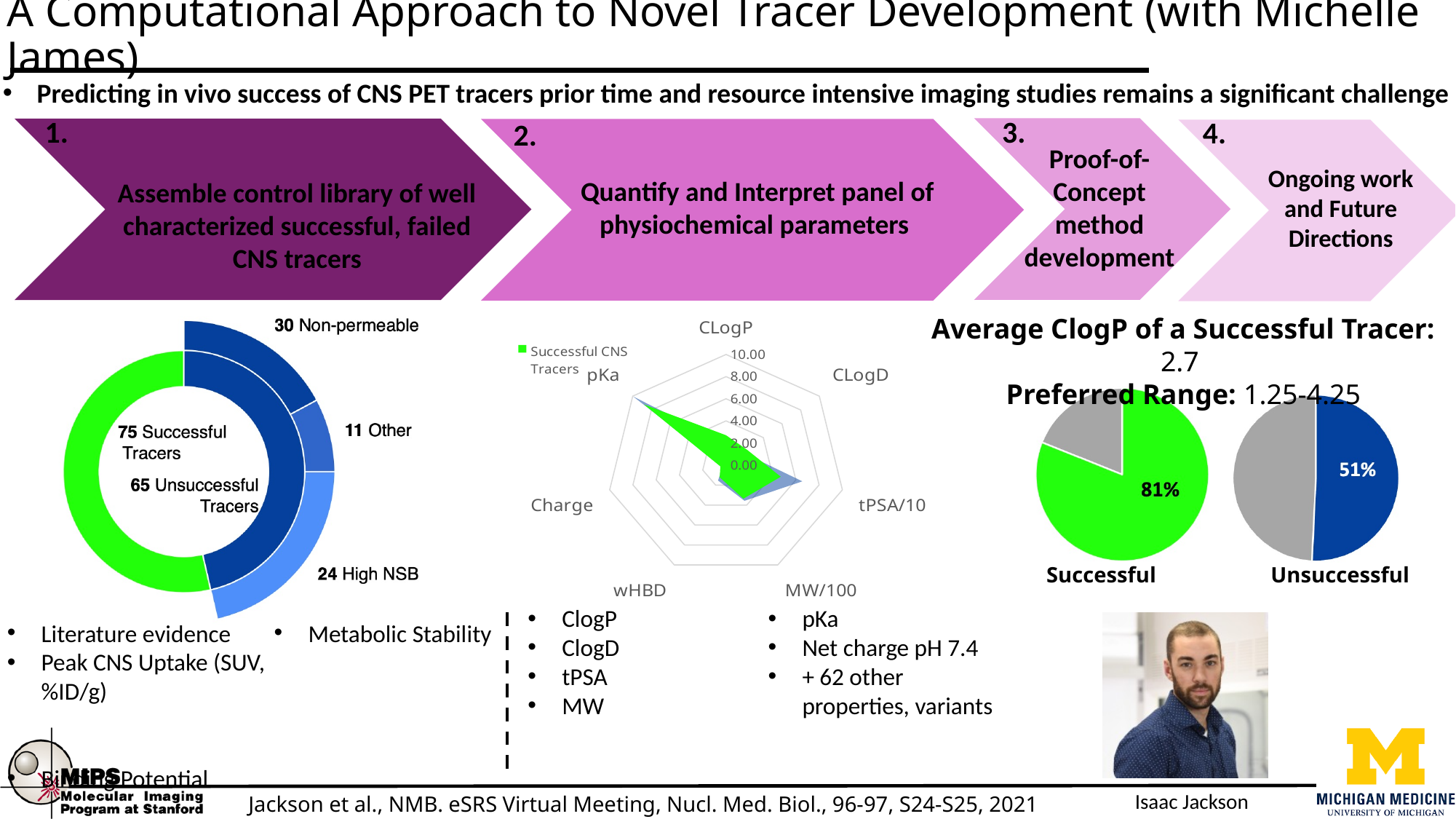
In the donut chart on the left, what is the difference between the number of successful and unsuccessful tracers? 10 Which of the two pie charts on the right shows the larger percentage, Successful or Unsuccessful? Successful In the donut chart on the left, how many successful tracers are there? 75 In the donut chart on the left, which outer-ring category has the smallest count: Non-permeable, Other, or High NSB? Other In the donut chart on the left, how many unsuccessful tracers are there? 65 In the donut chart on the left, how many tracers are labelled Non-permeable? 30 In the pie chart labelled Successful on the right, what percentage is shown? 81% In the pie chart labelled Unsuccessful on the right, what percentage is shown? 51% In the donut chart on the left, how many tracers are labelled High NSB? 24 What kind of chart is the middle chart with axes CLogP, CLogD and tPSA/10? Radar chart In the donut chart on the left, what is the total of the Non-permeable, Other and High NSB counts? 65 How many axes (categories) does the radar chart in the middle have? 7